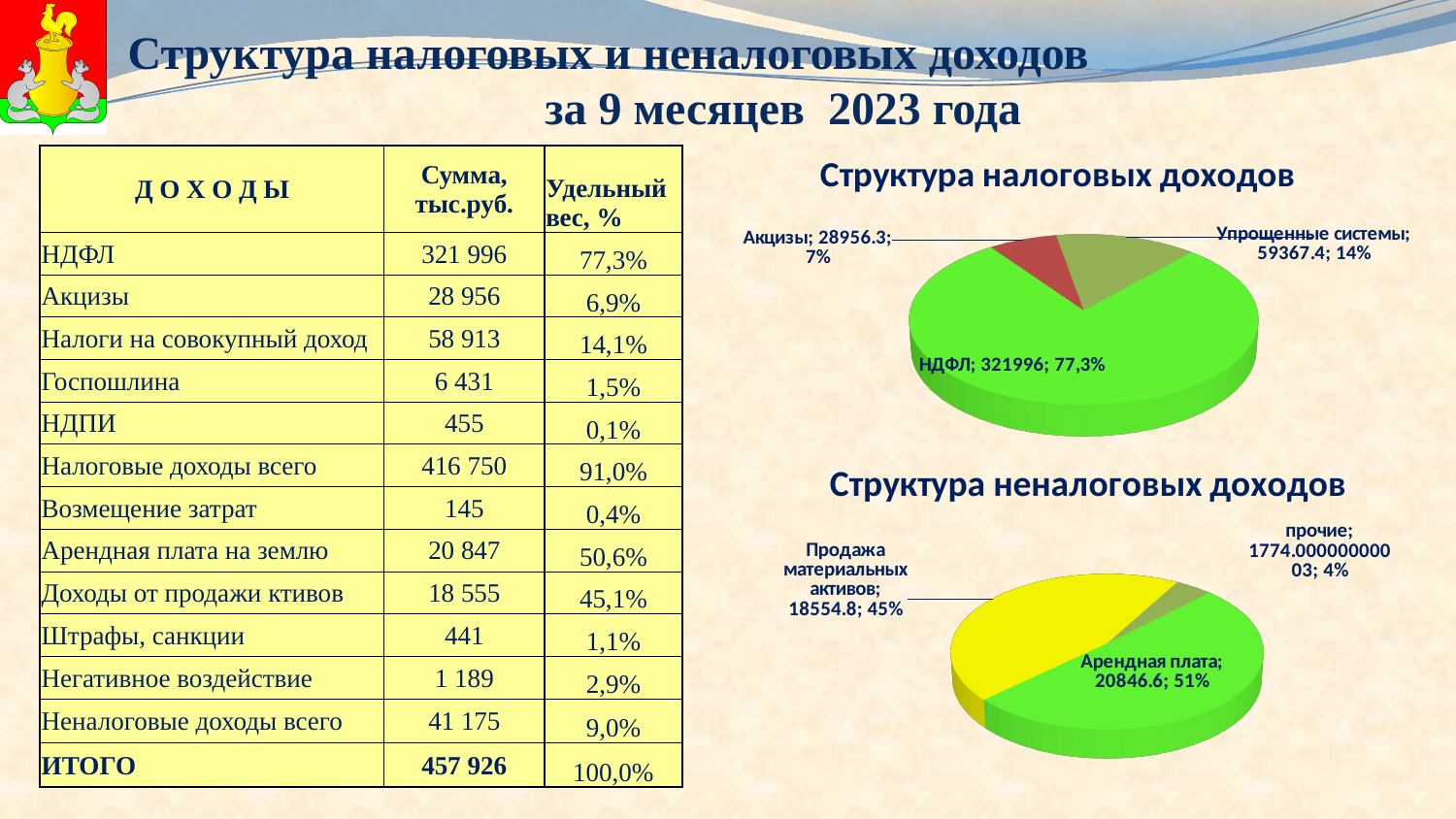
In the chart titled "Структура неналоговых доходов", which is larger: Арендная плата or Продажа материальных активов? Арендная плата In the chart titled "Структура неналоговых доходов", what share of the pie does Продажа материальных активов have? 45% In the chart titled "Структура налоговых доходов", which slice is the smallest? Акцизы In the chart titled "Структура неналоговых доходов", what value is shown for Арендная плата? 20846.6 In the chart titled "Структура налоговых доходов", what value is shown for Акцизы? 28956.3 In the chart titled "Структура неналоговых доходов", which slice is the smallest? прочие What kind of chart is "Структура неналоговых доходов"? Pie chart In the chart titled "Структура налоговых доходов", what share of the pie does Упрощенные системы have? 14% In the chart titled "Структура налоговых доходов", which slice is the largest? НДФЛ In the chart titled "Структура неналоговых доходов", what is the difference in percentage share between Арендная плата and Продажа материальных активов? 6% In the chart titled "Структура налоговых доходов", what value is shown for НДФЛ? 321996 How many slices does the chart titled "Структура налоговых доходов" have? 3